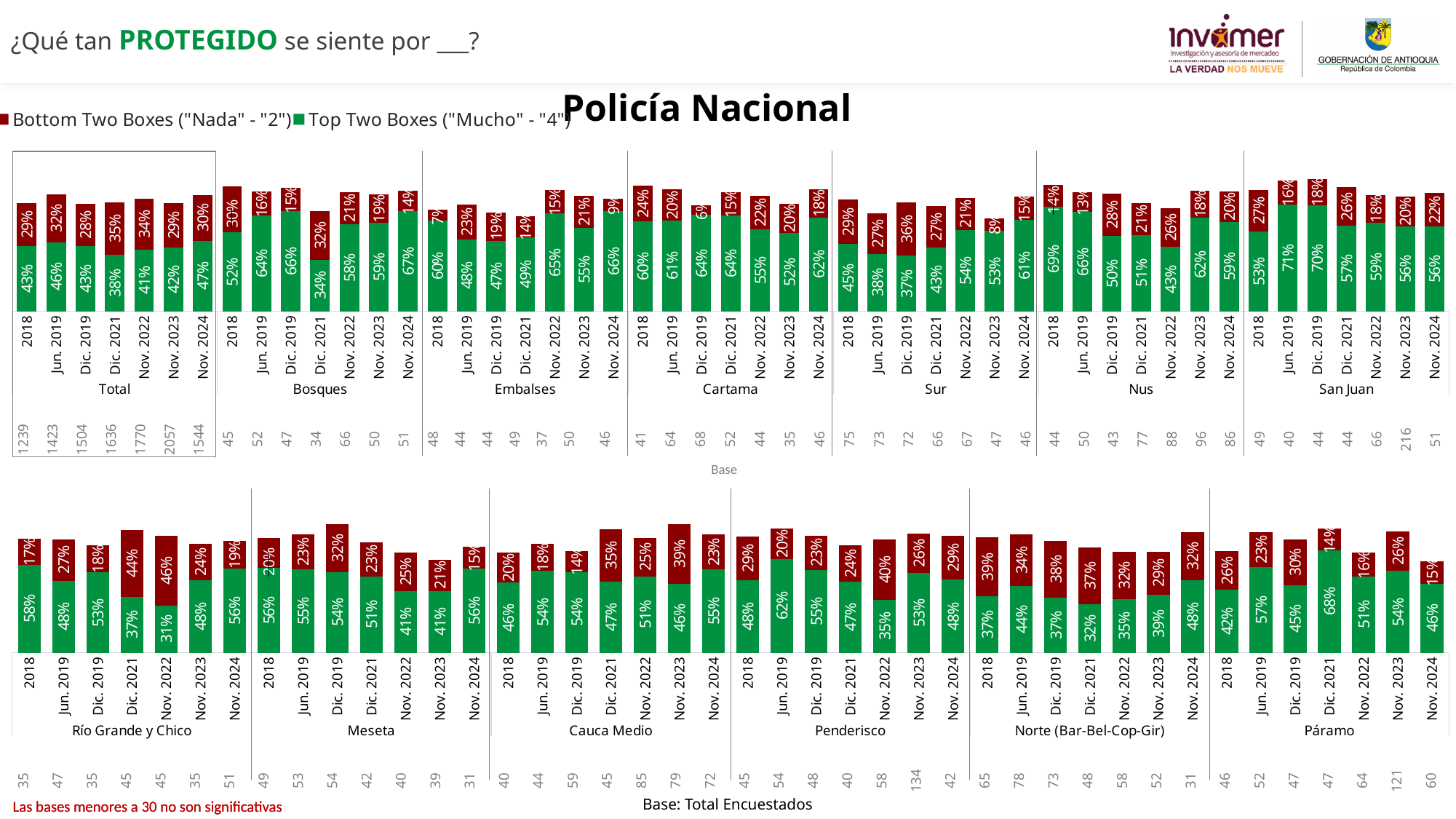
In the top chart, what is the combined total of the Top Two Boxes and Bottom Two Boxes values for Nus in 2018? 83% In the bottom chart, which is larger for Penderisco in Nov. 2022: the Top Two Boxes value or the Bottom Two Boxes value? Bottom Two Boxes In the bottom chart, what is the Top Two Boxes value for Páramo in Dic. 2021? 68% In the bottom chart, which period has the lowest Top Two Boxes value within the Río Grande y Chico group? Nov. 2022 What type of chart is used on this slide? Stacked bar chart How many periods are shown for each region group in the top chart? 7 In the top chart, which period has the highest Top Two Boxes value within the Total group? Nov. 2024 In the top chart, what is the Top Two Boxes value for Total in Nov. 2024? 47% In the top chart, what is the difference between the Top Two Boxes values for Bosques in Dic. 2019 and Dic. 2021? 32% How many series does the legend list? 2 Which colour represents the Top Two Boxes series in the legend? Green In the top chart, what is the Bottom Two Boxes value for Sur in Dic. 2019? 36%